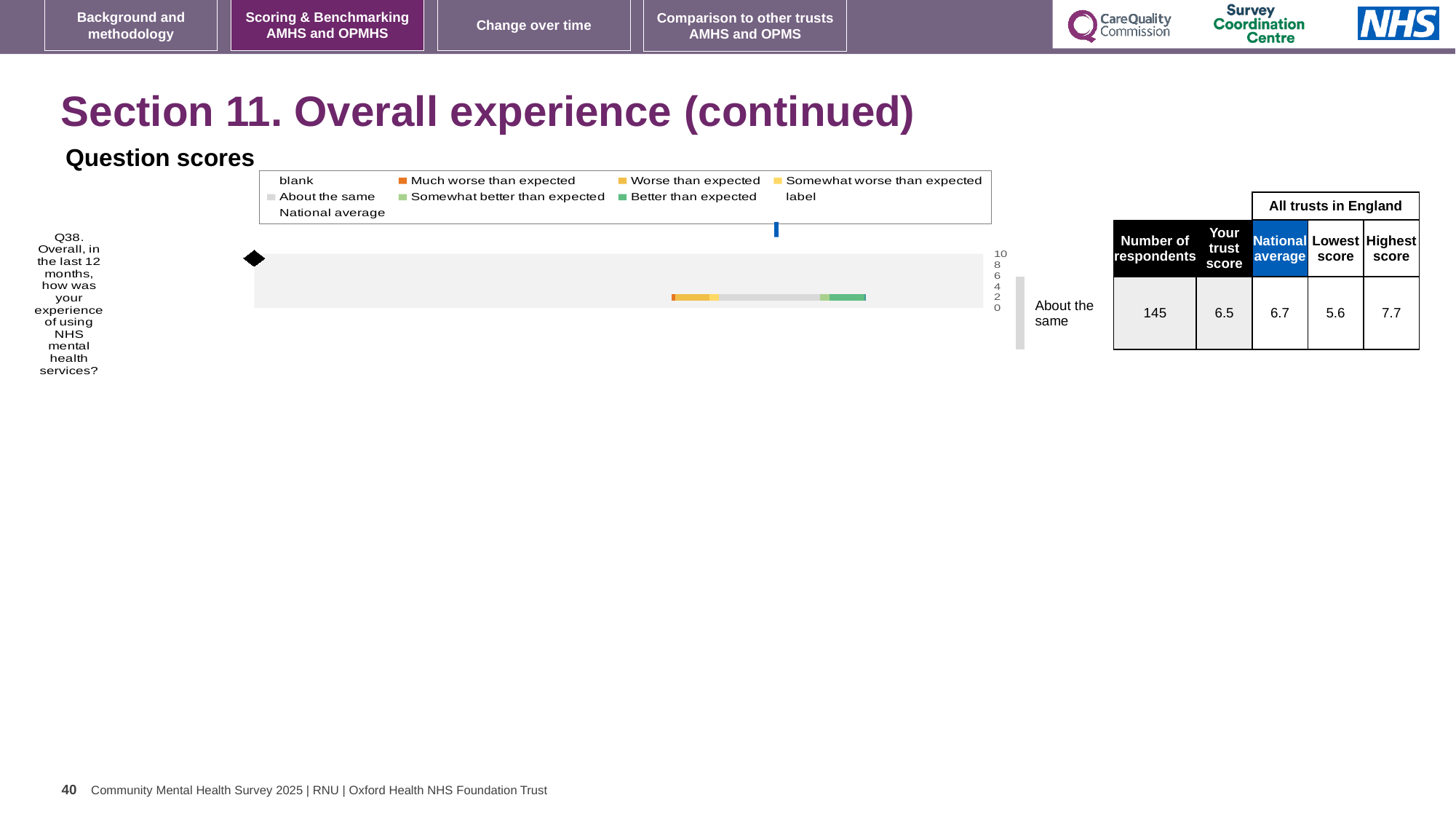
In the Question scores chart, what benchmark label is shown next to the bar for Q38? About the same What is the lowest score across all trusts in England for Q38? 5.6 For Q38, which is larger: the trust score or the national average? National average How many respondents answered Q38? 145 What is the trust score for Q38 shown alongside the Question scores chart? 6.5 What is the national average for Q38 shown alongside the Question scores chart? 6.7 For Q38, what is the difference between the highest score and the lowest score across all trusts in England? 2.1 What kind of chart is shown under 'Question scores'? Bar chart For Q38, what is the difference between the national average and the trust score? 0.2 How many questions are plotted in the Question scores chart? 1 What is the highest score across all trusts in England for Q38? 7.7 In the Question scores chart legend, what colour represents 'Better than expected'? Green